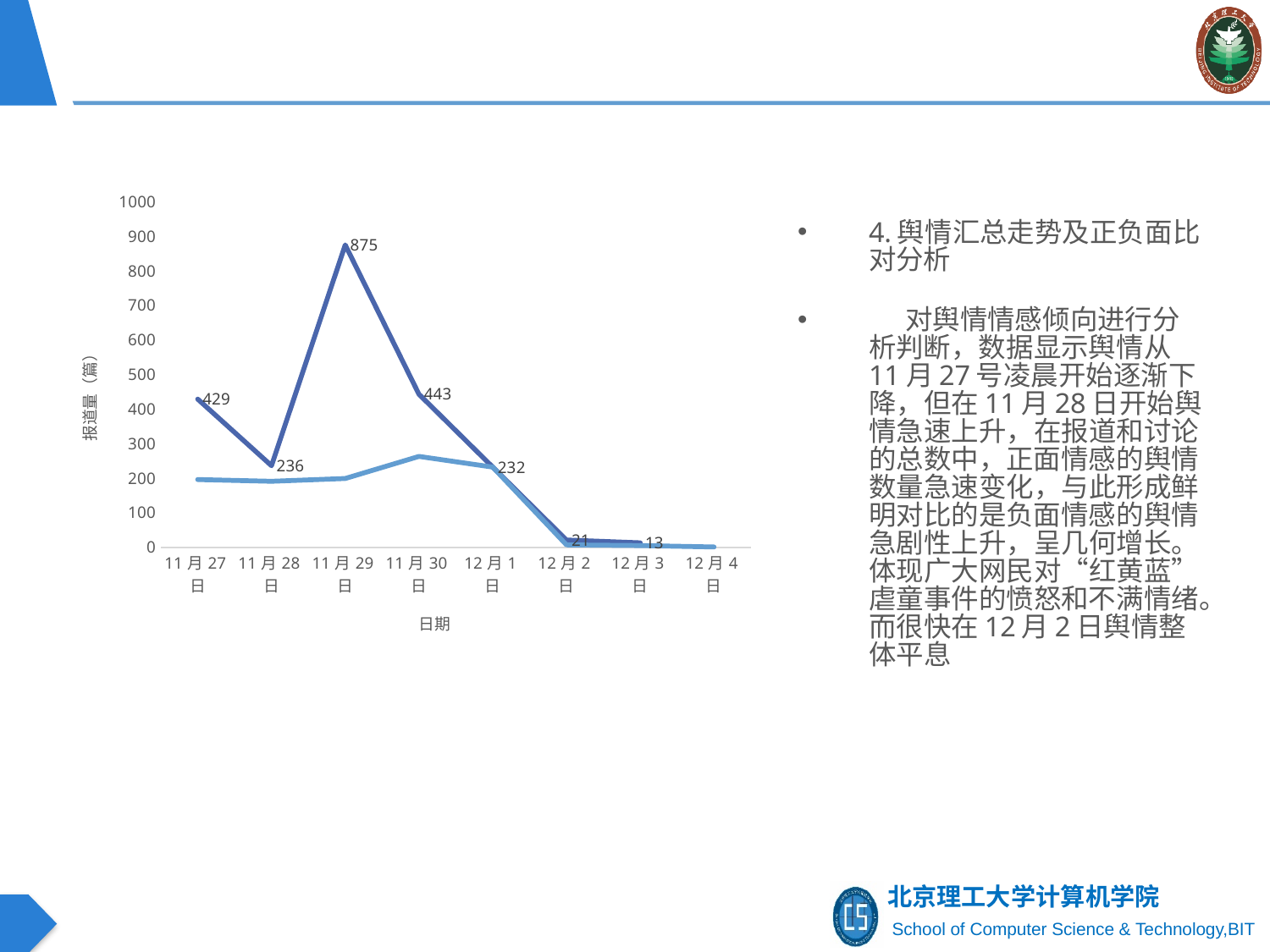
On which date does the dark blue line reach its highest value? 11月29日 What is the value of the dark blue line on 12月1日? 232 What is the difference between the dark blue line's values on 11月29日 and 11月30日? 432 Does the dark blue line rise or fall from 11月29日 to 12月3日? fall Which is larger for the dark blue line: the value on 11月27日 or on 11月28日? 11月27日 What is the title of the y axis? 报道量（篇） What is the value of the dark blue line on 11月29日? 875 Is the value of the light blue line on 11月30日 greater or less than 200? greater What kind of chart is shown on the slide? line chart How many dates are shown on the x axis? 8 What is the value of the dark blue line on 11月27日? 429 Is the value of the light blue line on 11月27日 greater or less than 300? less